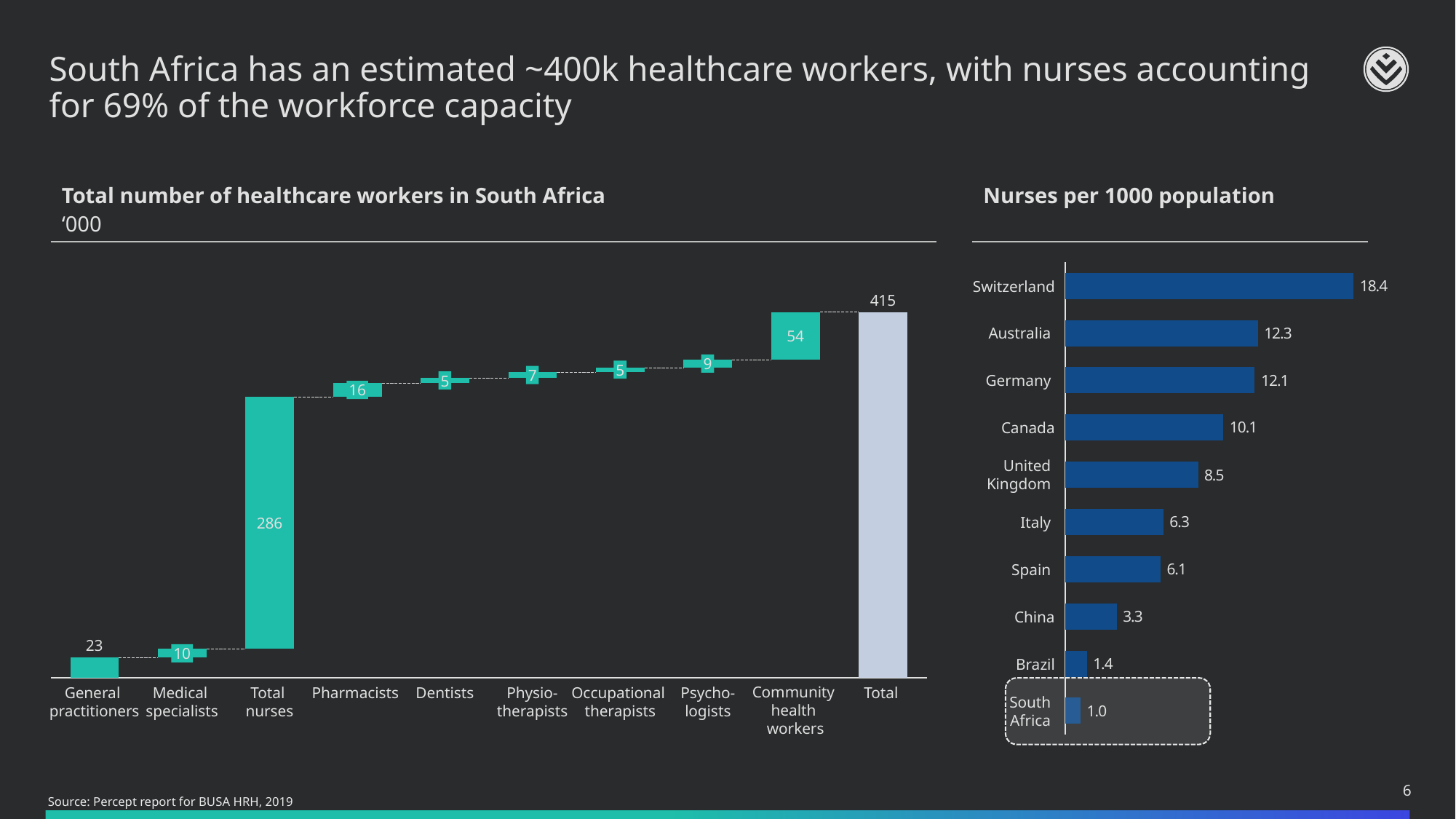
What kind of chart is the 'Nurses per 1000 population' chart? Bar chart In the 'Nurses per 1000 population' chart, what is the difference between Australia and Germany? 0.2 In the 'Total number of healthcare workers in South Africa' chart, which is larger, Pharmacists or Psychologists? Pharmacists In the 'Total number of healthcare workers in South Africa' chart, what is the difference between General practitioners and Medical specialists? 13 In the 'Total number of healthcare workers in South Africa' chart, what is the value of the Total bar? 415 In the 'Total number of healthcare workers in South Africa' chart, what is the value for Community health workers? 54 In the 'Nurses per 1000 population' chart, which country has the lowest value? South Africa In the 'Nurses per 1000 population' chart, what is the value for Switzerland? 18.4 In the 'Total number of healthcare workers in South Africa' chart, which category other than Total has the highest value? Total nurses In the 'Nurses per 1000 population' chart, what is the value for South Africa? 1.0 In the 'Nurses per 1000 population' chart, how many countries are shown? 10 In the 'Total number of healthcare workers in South Africa' chart, what is the value for Total nurses? 286